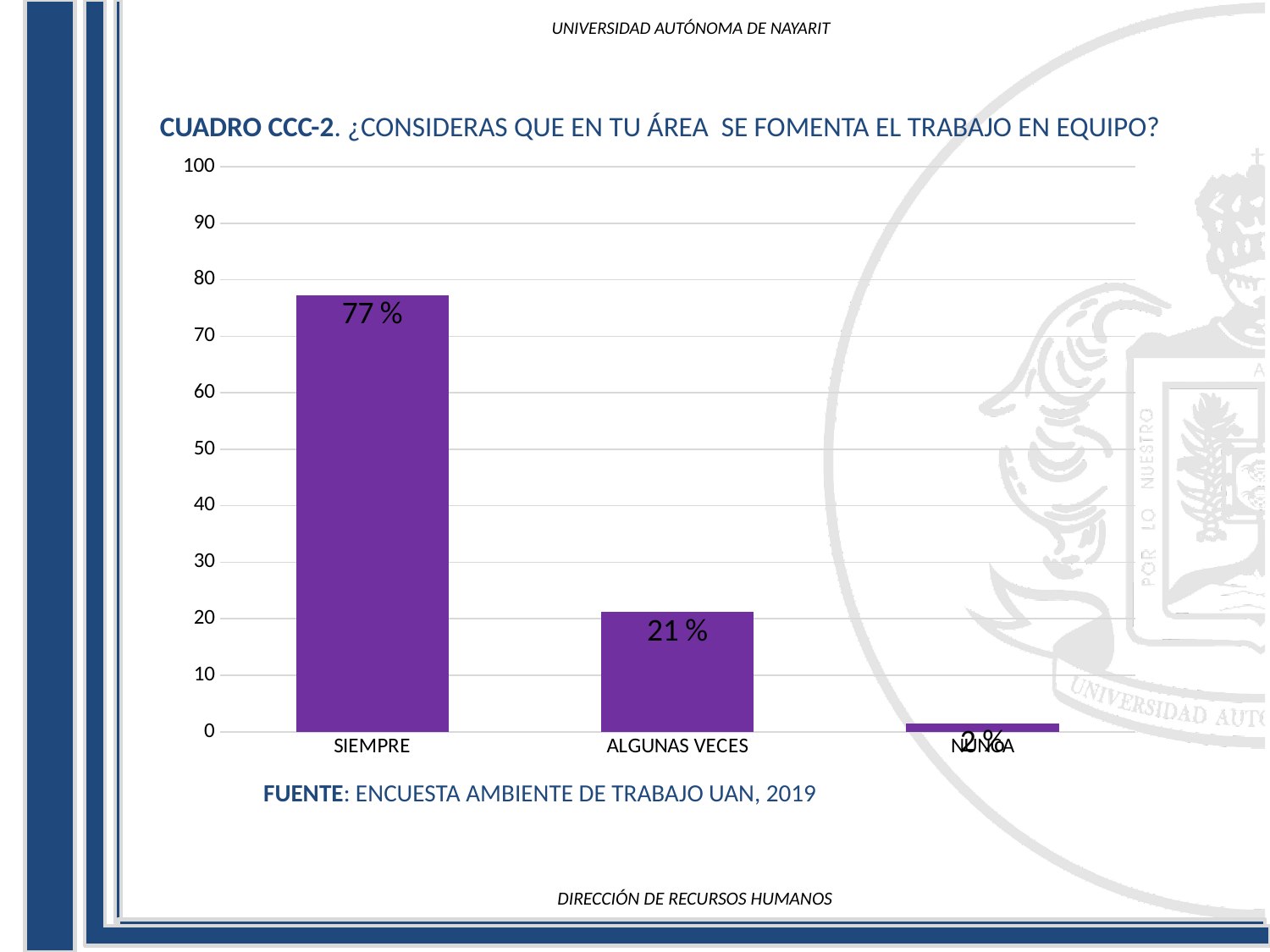
What is the source cited below the chart? ENCUESTA AMBIENTE DE TRABAJO UAN, 2019 Is the value for SIEMPRE greater or less than 70? greater What is the difference between the values for SIEMPRE and ALGUNAS VECES? 56 % What type of chart is shown on the slide? bar chart Do the values rise or fall from left to right along the x axis? fall What is the value for ALGUNAS VECES? 21 % How many categories are shown on the x axis? 3 Which category has the highest value? SIEMPRE Which category has the lowest value? NUNCA Is the value for NUNCA greater or less than 10? less Which is larger, the value for ALGUNAS VECES or the value for NUNCA? ALGUNAS VECES What is the value for SIEMPRE? 77 %